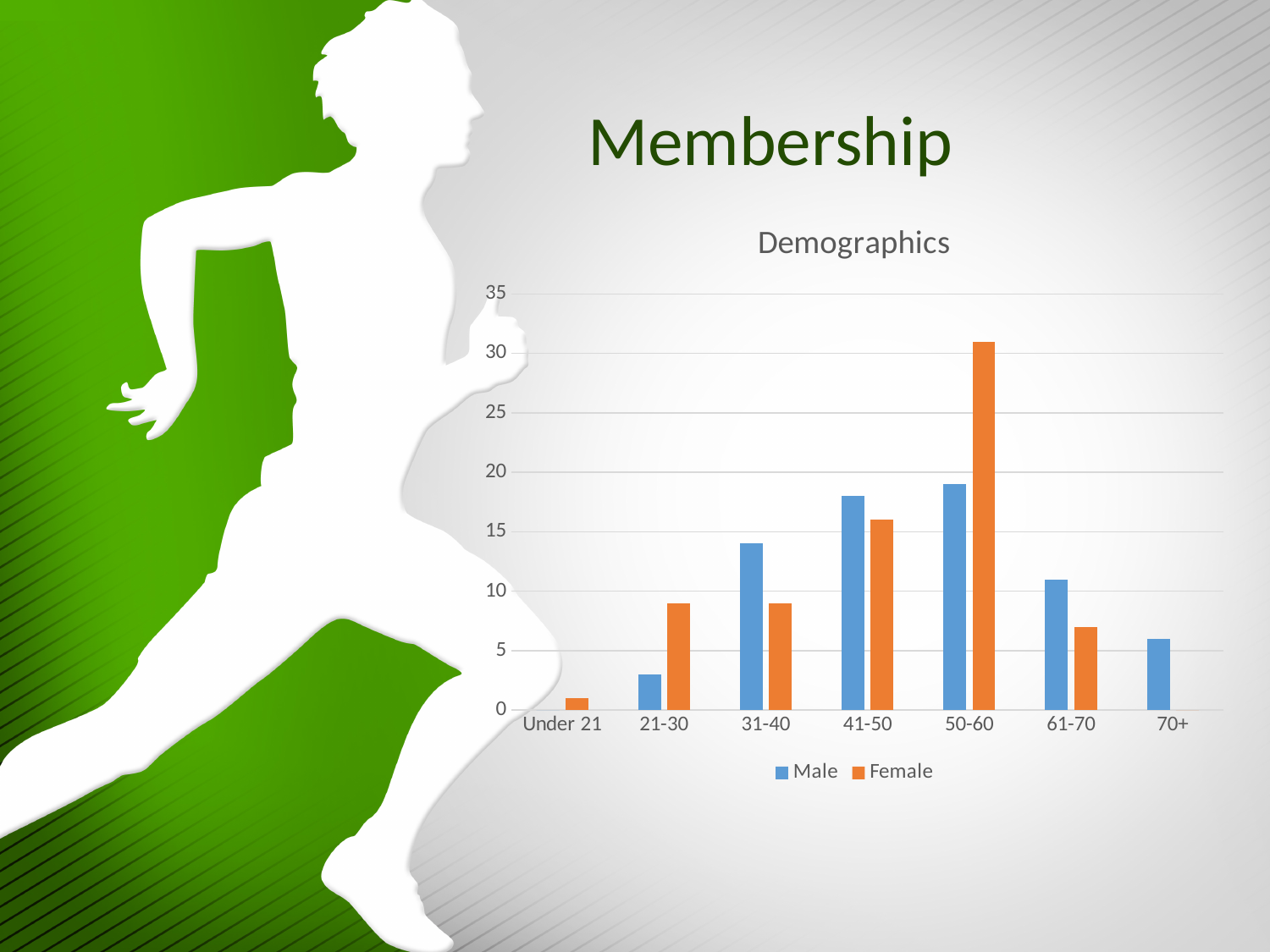
Is the Male value for 41-50 greater or less than 15? greater Is the Male value for 31-40 greater or less than 10? greater What kind of chart is shown on the slide? bar chart Is the Female value for 50-60 greater or less than 25? greater For the 50-60 age group, which is larger, Male or Female? Female For the 31-40 age group, which is larger, Male or Female? Male Which age group has the highest Female value? 50-60 What is the title of the chart? Demographics How many age categories are shown on the x axis? 7 How many series does the legend list? 2